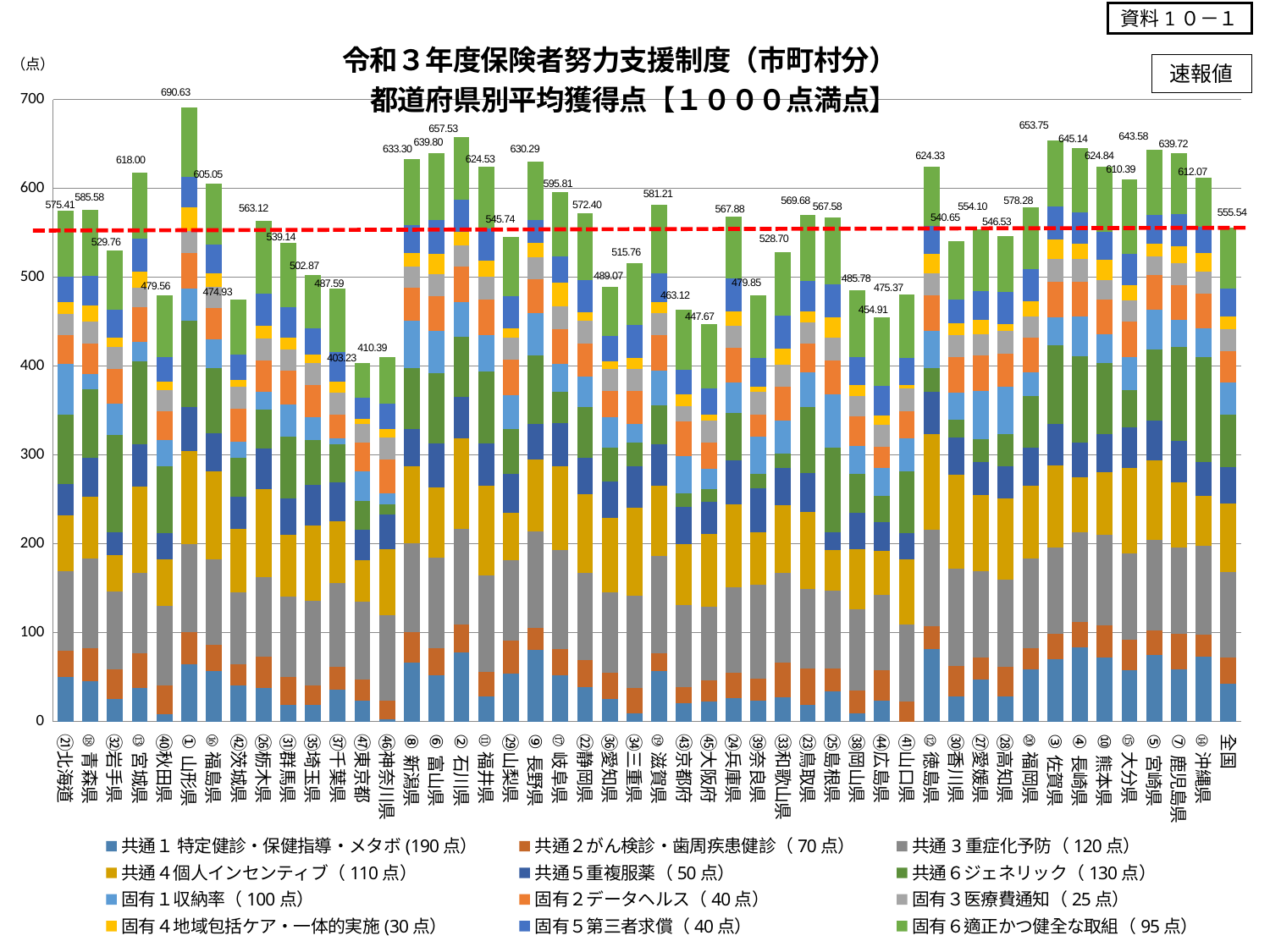
What kind of chart is shown? stacked bar chart How many bars are plotted on the chart? 48 Which prefecture has the lowest total score? 東京都 What is the difference between the total for 山形県 and the total for 東京都? 287.40 What is the total value shown for 東京都? 403.23 What is the total value shown for 山形県? 690.63 Which has a larger total, 石川県 or 佐賀県? 石川県 Is the total for 大阪府 greater or less than 500? less Which prefecture has the highest total score? 山形県 What is the maximum possible score stated in the chart title? 1000点 How many series does the legend list? 12 What is the total value shown for 全国? 555.54